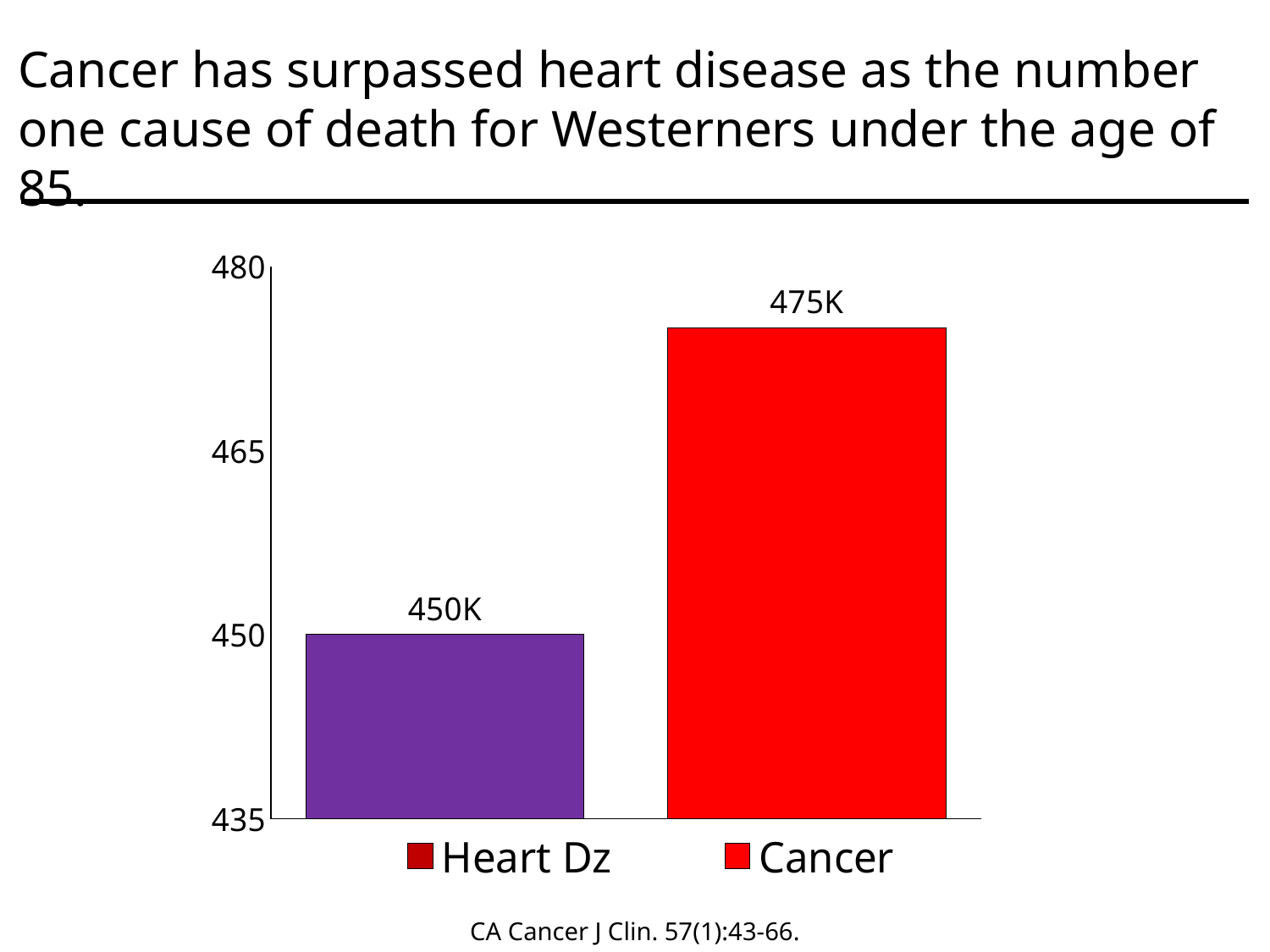
What is the difference between the Cancer value and the Heart Dz value? 25K How many bars are plotted in the chart? 2 Which bar is the highest? Cancer Which bar is the lowest? Heart Dz What is the value shown for Cancer? 475K Is the value for Cancer greater or less than 465? greater What is the value shown for Heart Dz? 450K Is the value for Heart Dz greater or less than 465? less Which is larger, the value for Cancer or the value for Heart Dz? Cancer What kind of chart is shown on the slide? bar chart What is the source citation printed below the chart? CA Cancer J Clin. 57(1):43-66. How many entries does the legend list? 2